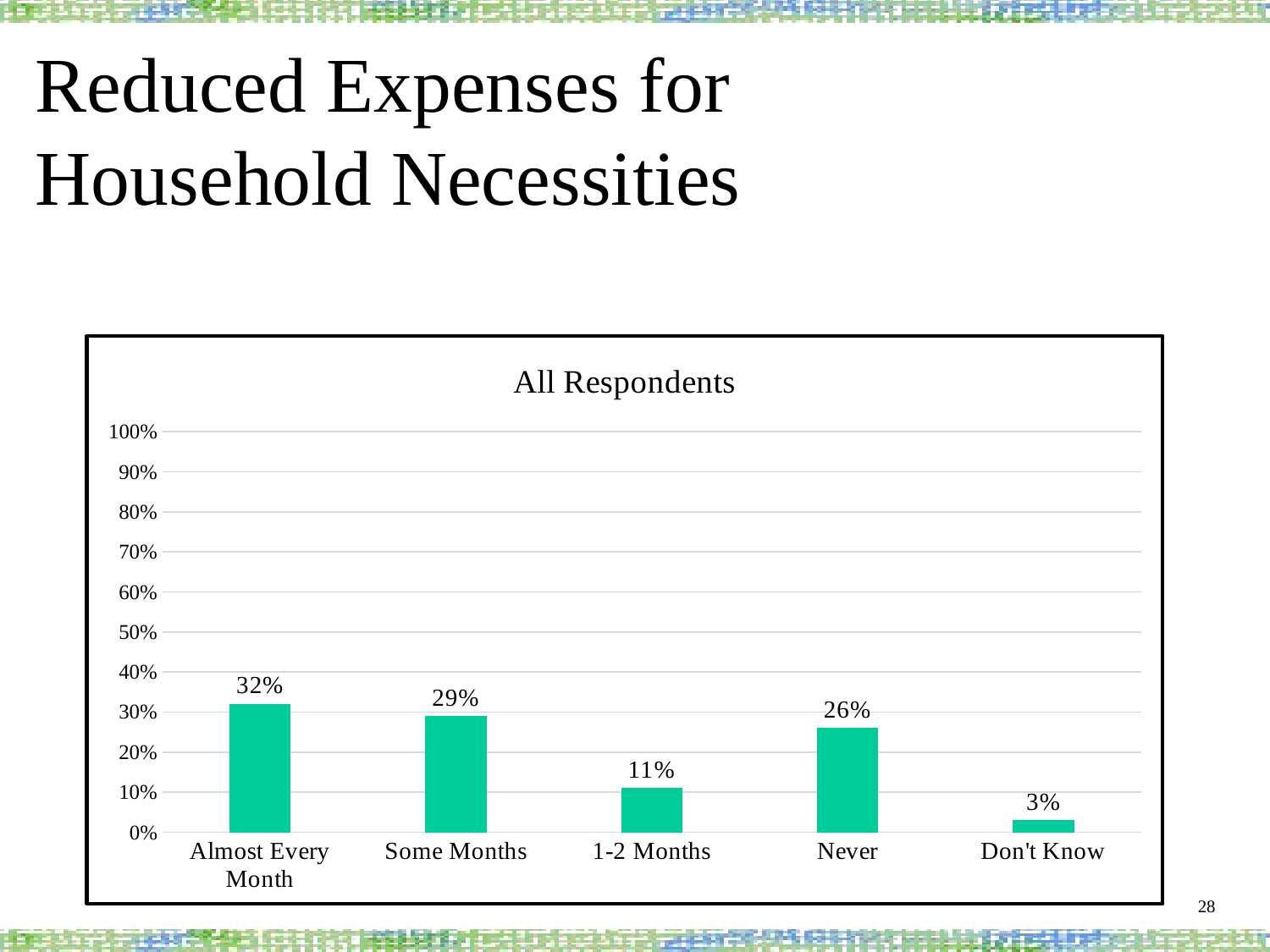
What is the title of the chart? All Respondents What is the value for Some Months? 29% Which is larger, the value for Some Months or the value for 1-2 Months? Some Months Which category has the highest value? Almost Every Month What is the value for Never? 26% How many categories are shown on the x axis? 5 What is the value for Almost Every Month? 32% Which category has the lowest value? Don't Know What is the difference between the values for Almost Every Month and Never? 6% What kind of chart is shown on the slide? Bar chart What is the value for Don't Know? 3% What is the value for 1-2 Months? 11%